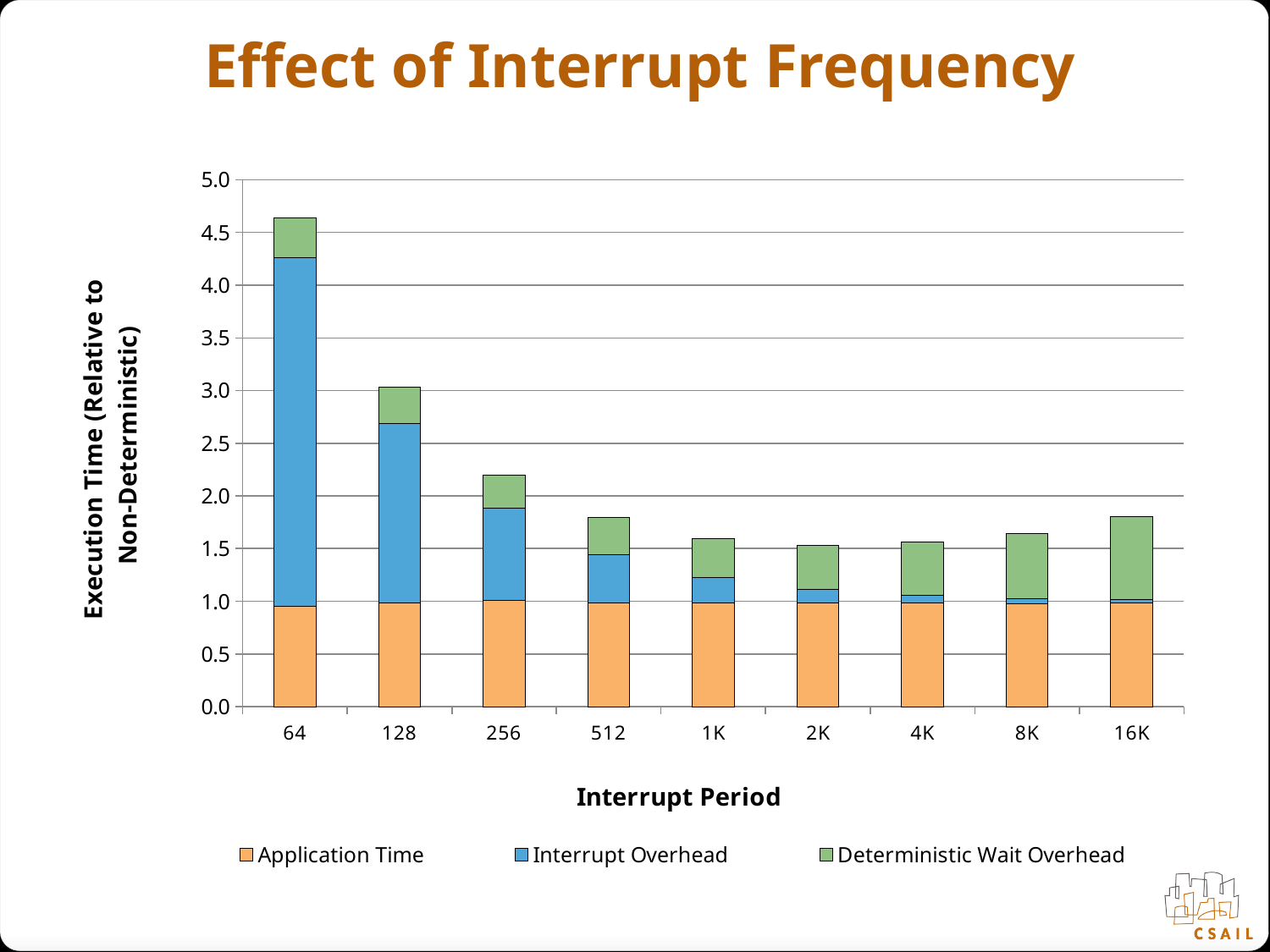
Which series is shown in green in the legend? Deterministic Wait Overhead Is the total execution time for interrupt period 128 greater or less than 2.5? greater How many interrupt period categories are shown on the x axis? 9 What kind of chart is shown on the slide? Stacked bar chart Does the Interrupt Overhead portion of the bars rise or fall as the interrupt period increases along the x axis? Fall Is the total execution time for interrupt period 256 greater or less than 2.0? greater Is the total execution time for interrupt period 512 greater or less than 2.0? less How many series does the legend list? 3 Which has a larger total execution time, interrupt period 64 or 128? 64 Which interrupt period has the highest total execution time? 64 What is the title of the x axis? Interrupt Period